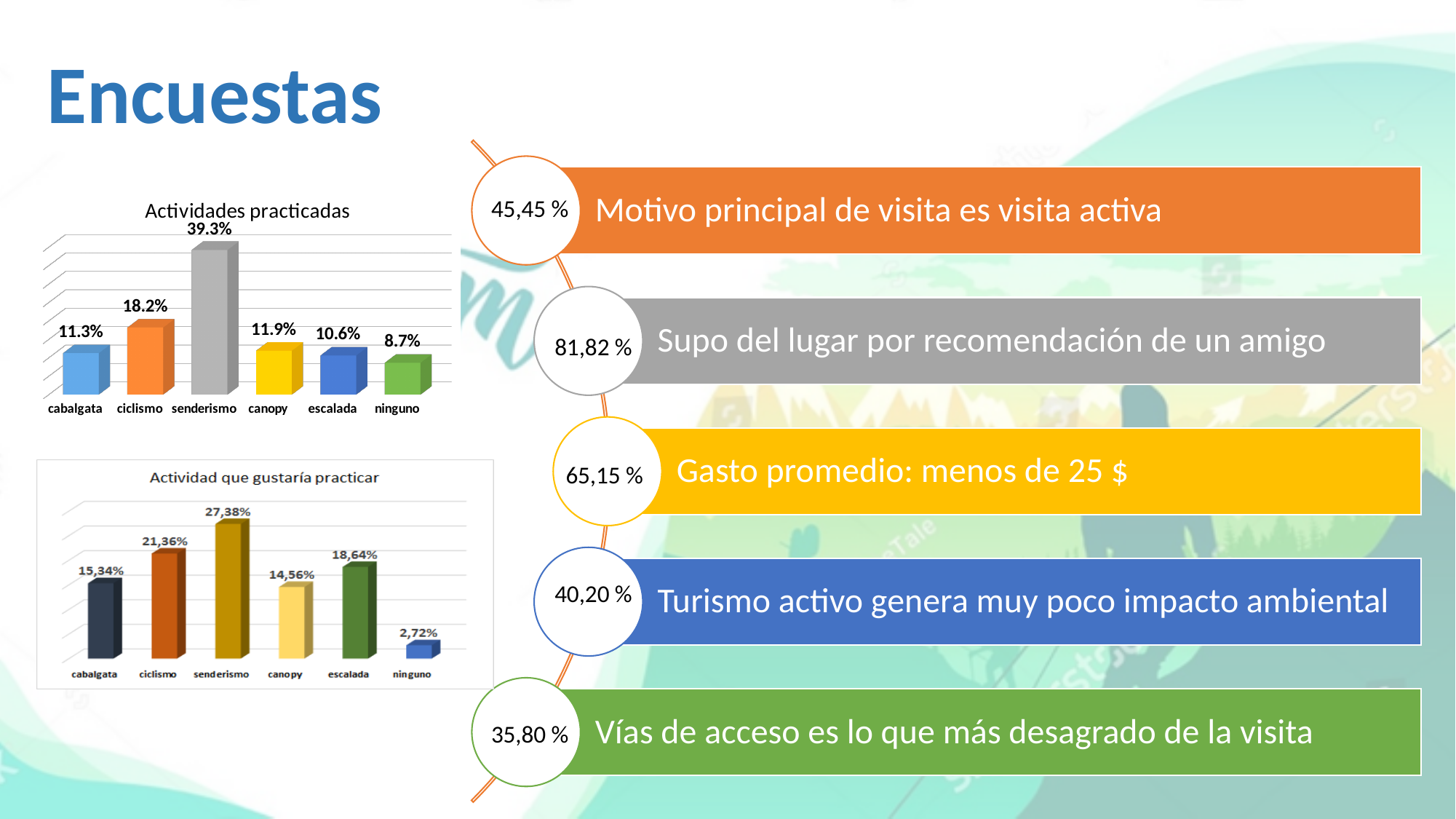
In the 'Actividad que gustaría practicar' chart, what is the value for ninguno? 2,72% In the 'Actividades practicadas' chart, what is the value for cabalgata? 11.3% In the 'Actividades practicadas' chart, what is the value for senderismo? 39.3% What type of chart is the 'Actividad que gustaría practicar' chart? bar chart In the 'Actividades practicadas' chart, what is the difference between senderismo and ciclismo? 21.1% In the 'Actividades practicadas' chart, which activity has the lowest value? ninguno In the 'Actividad que gustaría practicar' chart, what is the difference between senderismo and ciclismo? 6,02% In the 'Actividad que gustaría practicar' chart, what is the value for escalada? 18,64% In the 'Actividades practicadas' chart, which activity has the highest value? senderismo How many categories are shown in the 'Actividades practicadas' chart? 6 In the 'Actividad que gustaría practicar' chart, which activity has the highest value? senderismo In the 'Actividades practicadas' chart, which is larger, canopy or escalada? canopy